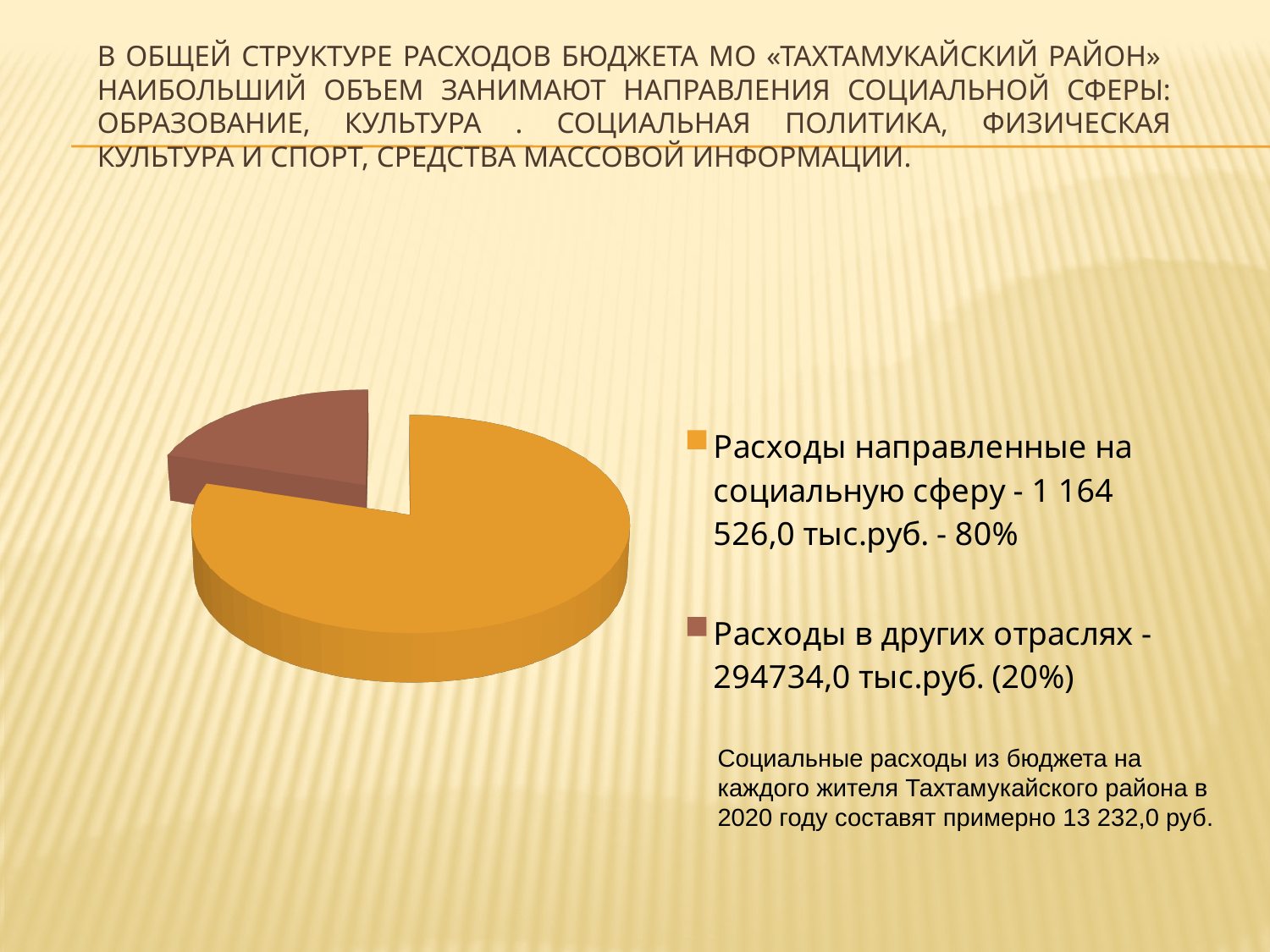
Which slice of the pie chart is the largest? Расходы направленные на социальную сферу What is the value for "Расходы направленные на социальную сферу" in thousand rubles? 1 164 526,0 тыс.руб. What kind of chart is shown on the slide? pie chart What is the difference in percentage points between the two slices of the pie chart? 60 What share of the pie is taken by "Расходы направленные на социальную сферу"? 80% Which is larger: the share for "Расходы направленные на социальную сферу" or for "Расходы в других отраслях"? Расходы направленные на социальную сферу What is the value for "Расходы в других отраслях" in thousand rubles? 294734,0 тыс.руб. Which slice of the pie chart is the smallest? Расходы в других отраслях How many entries does the legend of the pie chart list? 2 How many slices does the pie chart have? 2 What share of the pie is taken by "Расходы в других отраслях"? 20% What colour is the slice for "Расходы в других отраслях"? brown